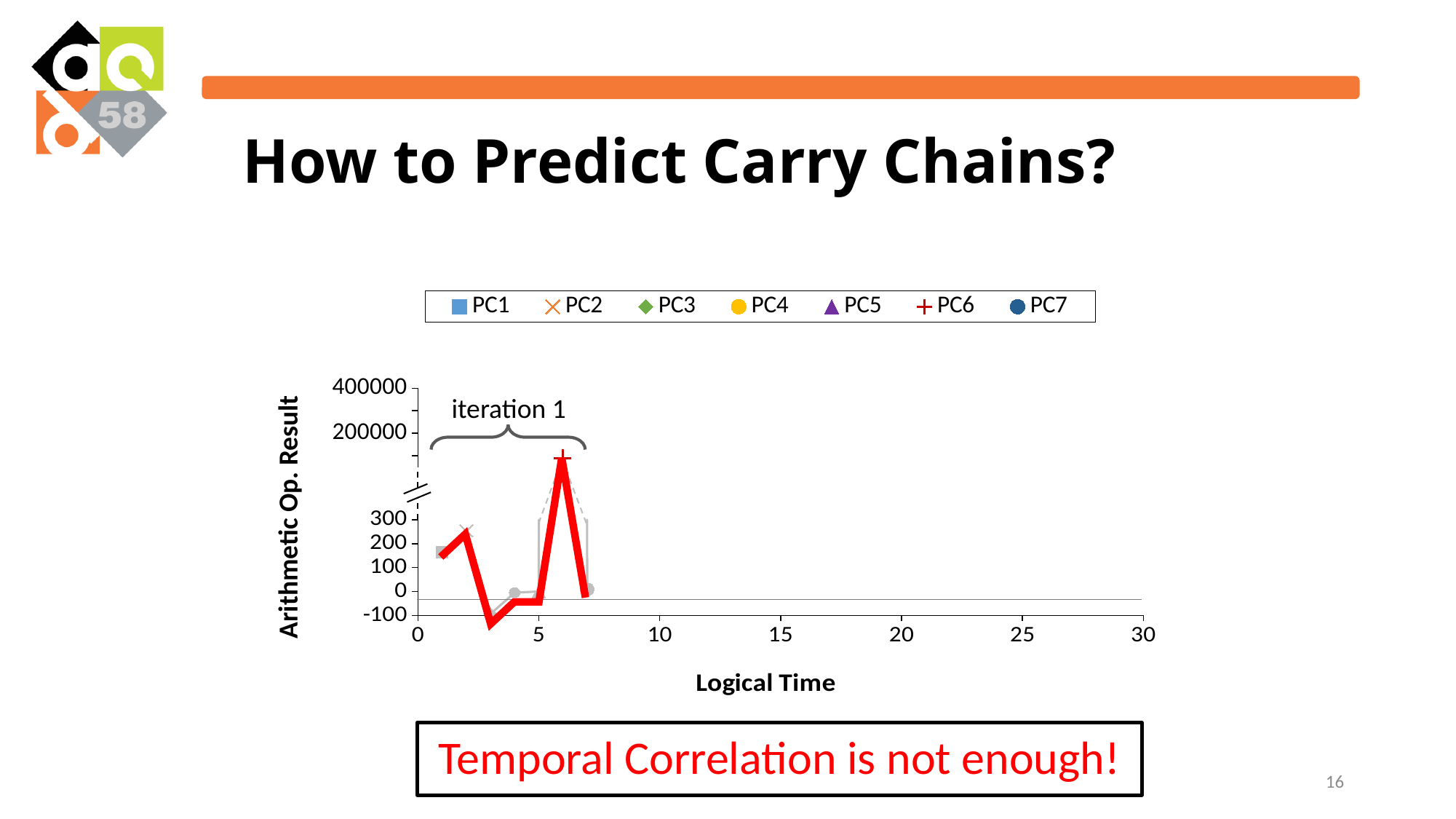
What is the title of the x axis? Logical Time Is the value for PC2 greater or less than 200? greater Which series has the lowest Arithmetic Op. Result? PC3 Which is larger, the value for PC2 or the value for PC4? PC2 Is the value for PC6 greater or less than 300? greater Is the value for PC3 greater or less than 0? less How many data points are plotted on the chart? 7 What kind of chart is shown on the slide? line chart Which series has the highest Arithmetic Op. Result? PC6 What is the title of the y axis? Arithmetic Op. Result How many series does the legend list? 7